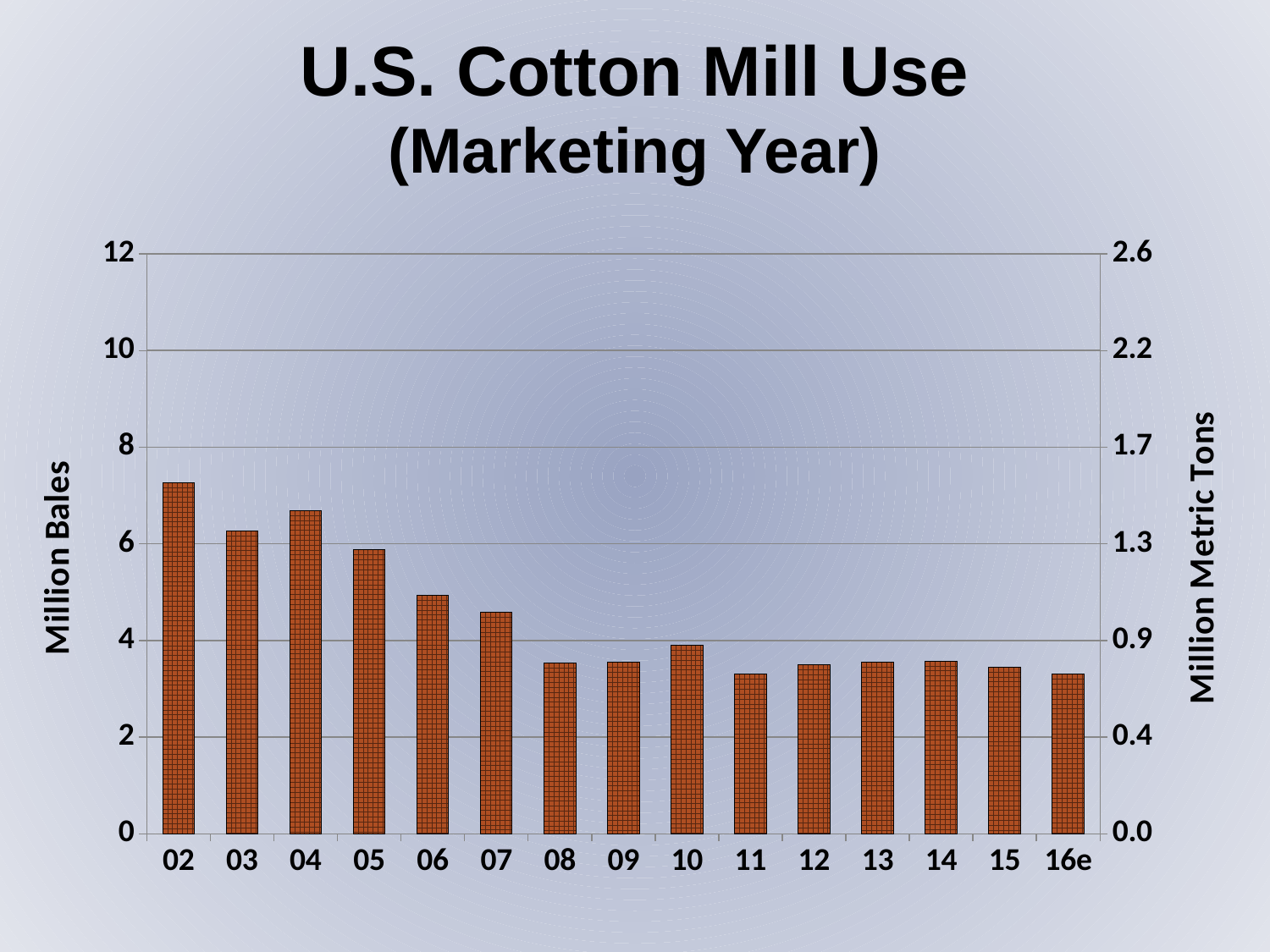
Is the value for 05 greater or less than 6 million bales? less How many marketing years are plotted on the chart? 15 Is the value for 02 greater or less than 6 million bales? greater What is the label of the left vertical axis? Million Bales Overall, do the values rise or fall from 02 to 16e? Fall What kind of chart is shown on the slide? Bar chart Which is larger, the value for 10 or the value for 11? 10 Which marketing year has the highest cotton mill use? 02 Is the value for 08 greater or less than 4 million bales? less Which is larger, the value for 04 or the value for 05? 04